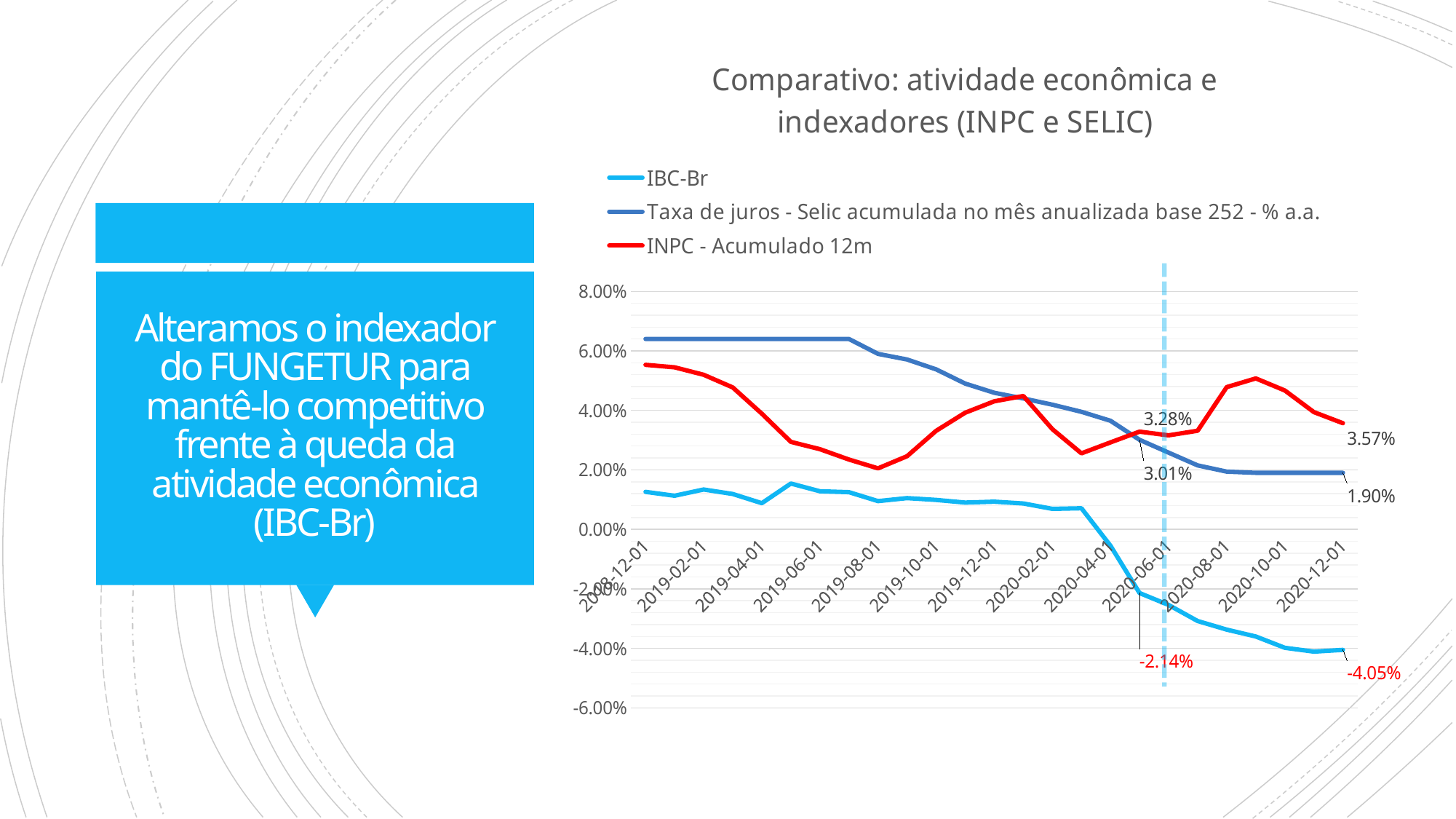
What is the difference between the INPC value (3.57%) and the Selic value (1.90%) labeled at 2020-12-01? 1.67% Is the INPC value at 2019-08-01 greater or less than 4.00%? less What kind of chart is shown on the slide? line chart What is the labeled value of INPC - Acumulado 12m at 2020-12-01? 3.57% How many series does the legend list? 3 Which series has the highest value at 2020-12-01? INPC - Acumulado 12m What is the title of the chart? Comparativo: atividade econômica e indexadores (INPC e SELIC) What is the value labeled in red on the IBC-Br line just before the dashed vertical line? -2.14% What is the labeled value of IBC-Br at 2020-12-01? -4.05% Is the Selic value at 2018-12-01 greater or less than 6.00%? greater What is the labeled value of the Selic series at 2020-12-01? 1.90% Does the IBC-Br line rise or fall overall from 2018-12-01 to 2020-12-01? fall